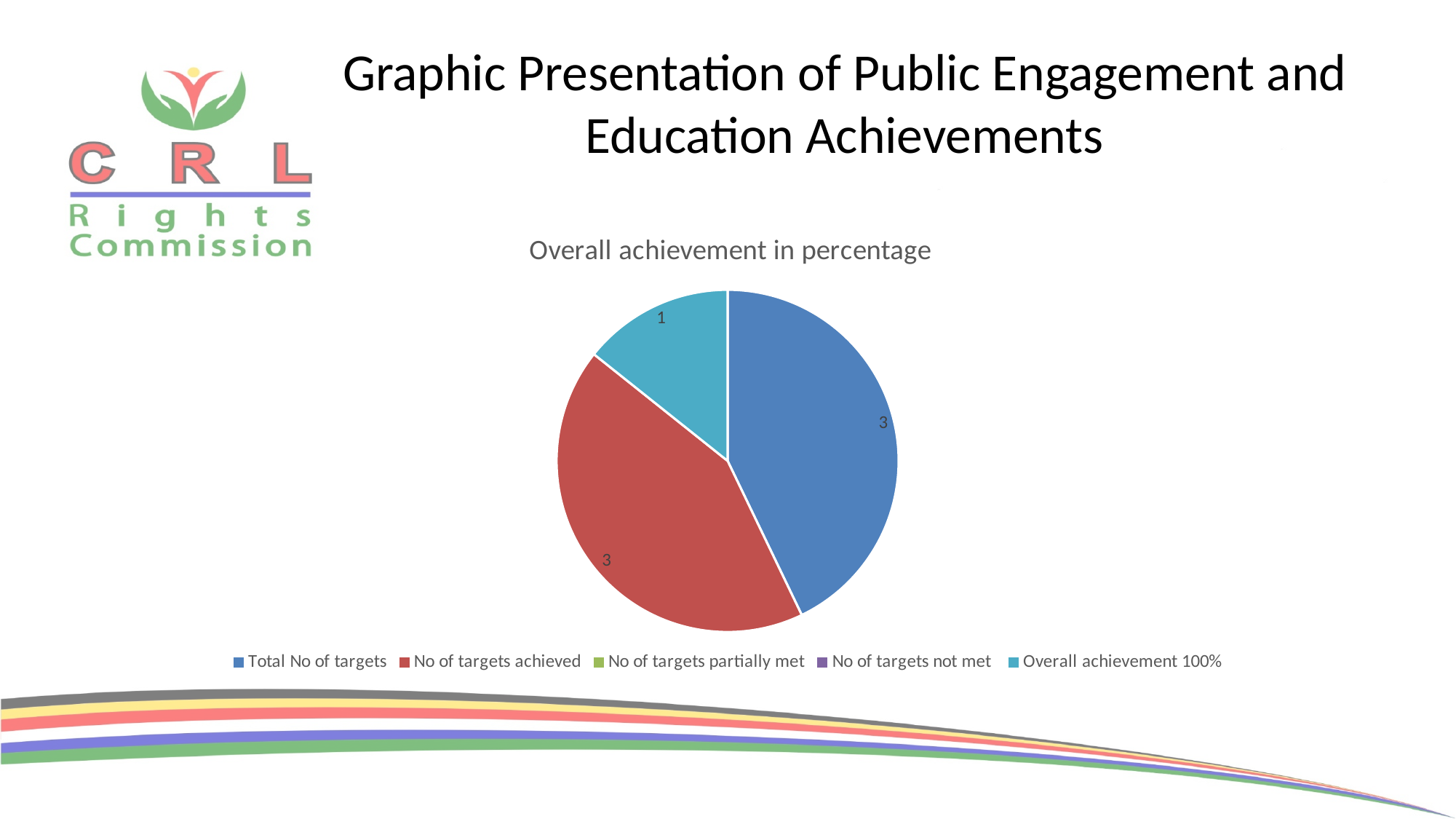
How many slices are visible in the pie chart? 3 What kind of chart is shown on the slide? Pie chart Which is larger, the Total No of targets slice or the Overall achievement 100% slice? Total No of targets What value is shown for the No of targets achieved slice? 3 How many entries does the legend list? 5 What value is shown for the Overall achievement 100% slice? 1 What colour represents No of targets achieved in the pie chart? Red What is the difference between the Total No of targets value and the Overall achievement 100% value? 2 Which slice is the smallest in the pie chart? Overall achievement 100% What value is shown for the Total No of targets slice? 3 What is the total of the values labelled on the pie slices? 7 What is the title of the chart? Overall achievement in percentage